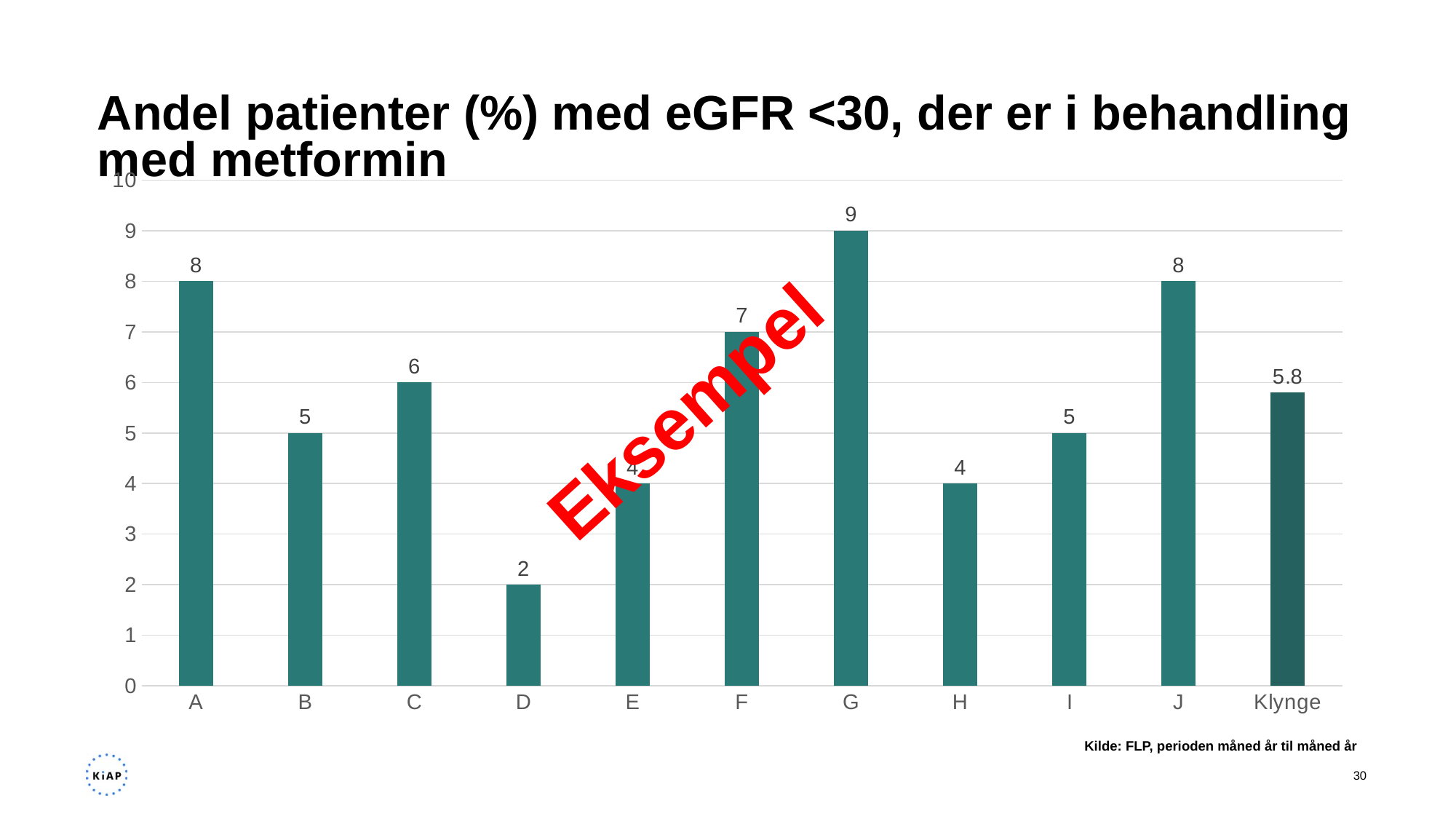
What is the difference between the values for G and D? 7 Which category has the highest value? G What kind of chart is shown on the slide? bar chart What is the value for D? 2 How many categories are shown on the x axis? 11 Which is larger, the value for F or the value for H? F What is the value for Klynge? 5.8 Which category has the lowest value? D What is the difference between the values for C and Klynge? 0.2 What is the value for G? 9 Is the value for J greater or less than 5? greater What is the title of the chart? Andel patienter (%) med eGFR <30, der er i behandling med metformin